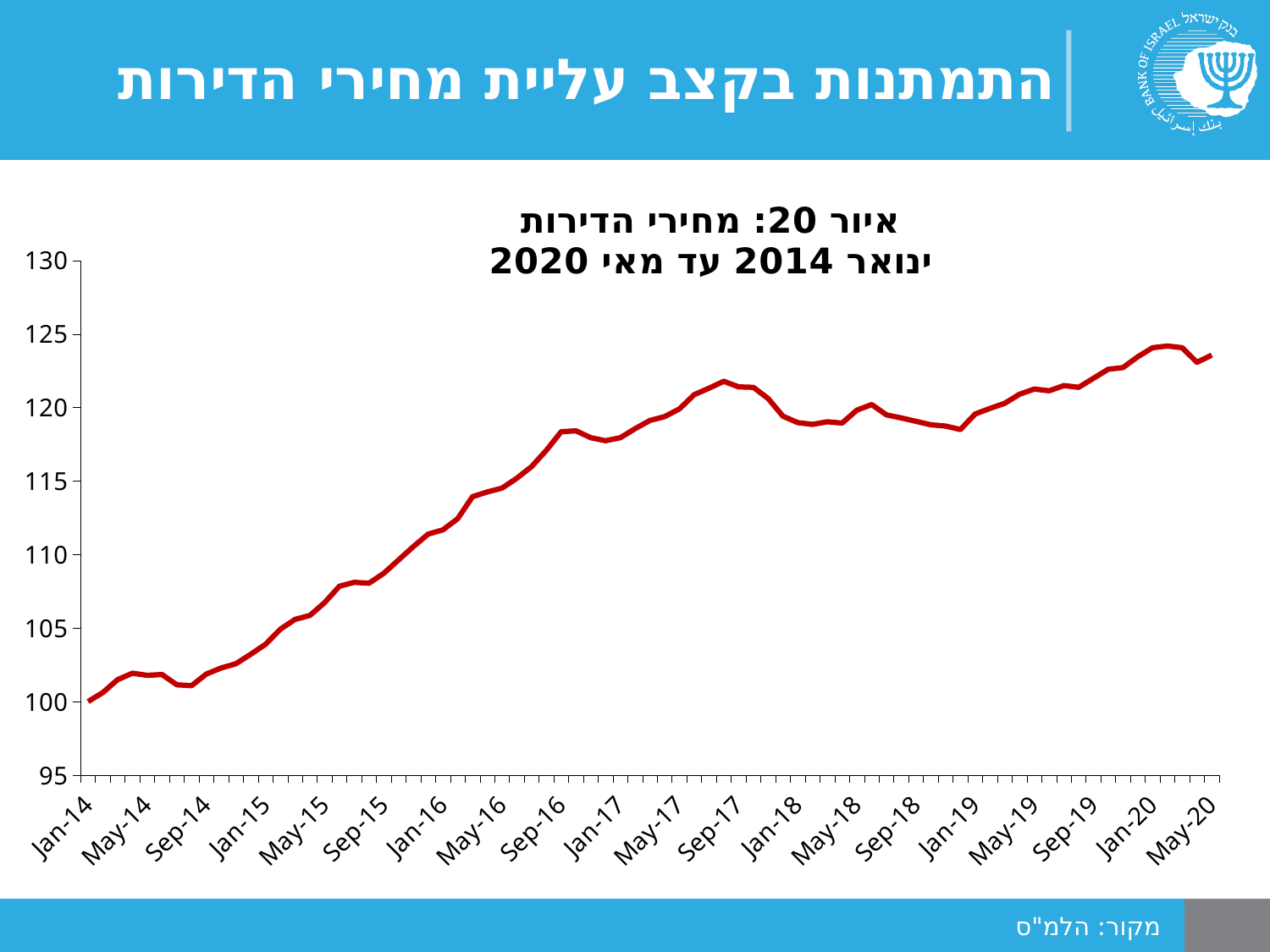
What is the title of the chart? איור 20: מחירי הדירות ינואר 2014 עד מאי 2020 What kind of chart is shown on the slide? line chart What is the value at Jan-14? 100 Is the value for May-20 greater or less than 120? greater What is the source cited at the bottom of the slide? הלמ"ס Is the value for Jan-17 greater or less than 120? less Which point on the x axis has the lowest value? Jan-14 Is the value for Sep-15 greater or less than 110? less Which is higher, the value at Jan-15 or the value at Jan-16? Jan-16 Which is higher, the value at Sep-17 or the value at Jan-19? Sep-17 Do the values generally rise or fall from Jan-14 to May-20? rise